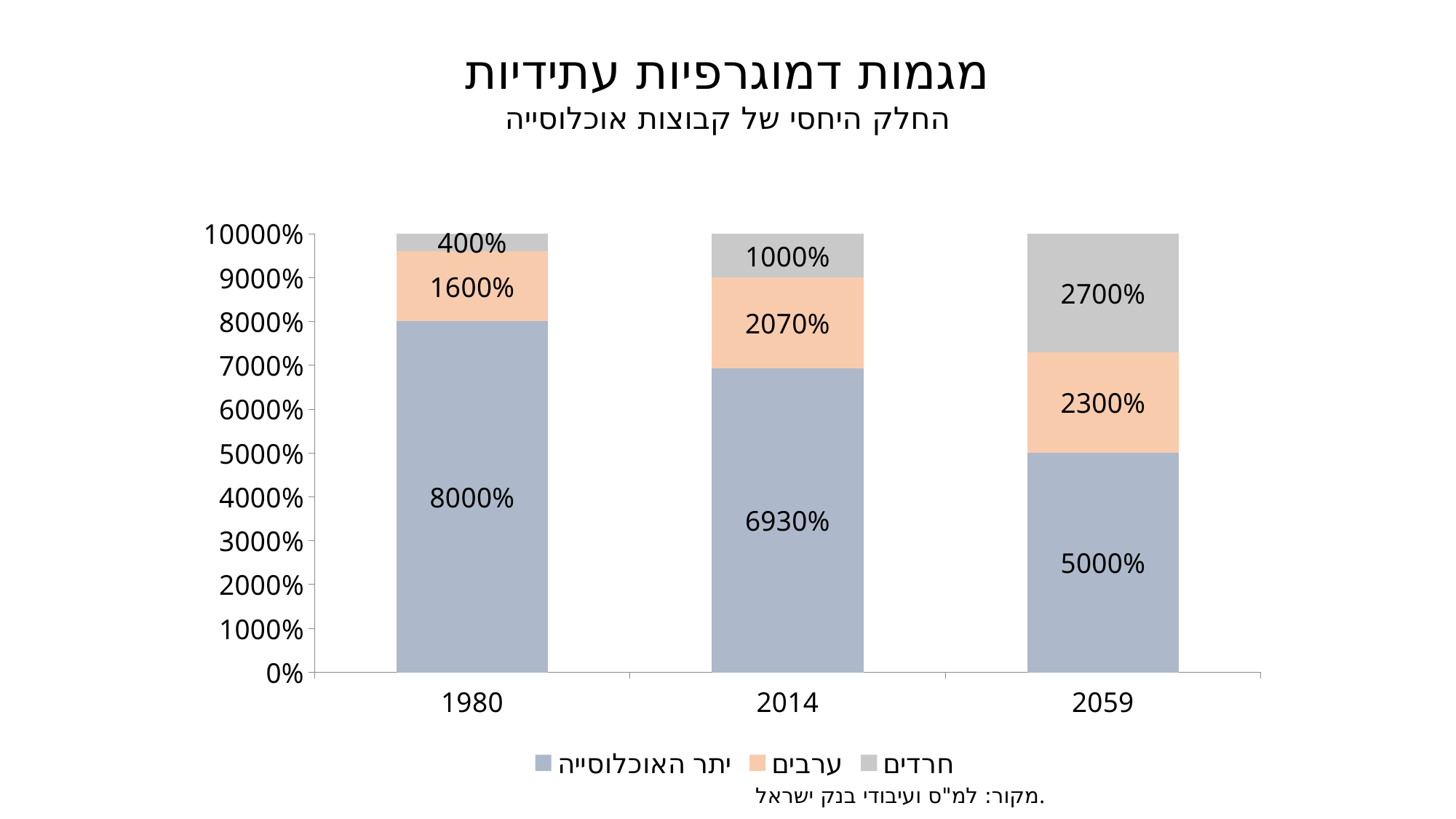
What is the value for ערבים in 2014? 2070% Does the value for חרדים rise or fall from 1980 to 2059? rise How many years are shown on the x axis? 3 What is the value for יתר האוכלוסייה in 1980? 8000% What is the value for חרדים in 2059? 2700% What is the difference between the value for יתר האוכלוסייה in 1980 and in 2059? 3000% What is the value for חרדים in 1980? 400% How many series does the legend list? 3 In which year is the value for יתר האוכלוסייה lowest? 2059 In which year is the value for חרדים highest? 2059 What kind of chart is shown on the slide? stacked bar chart Which is larger in 2059: the value for ערבים or the value for חרדים? חרדים